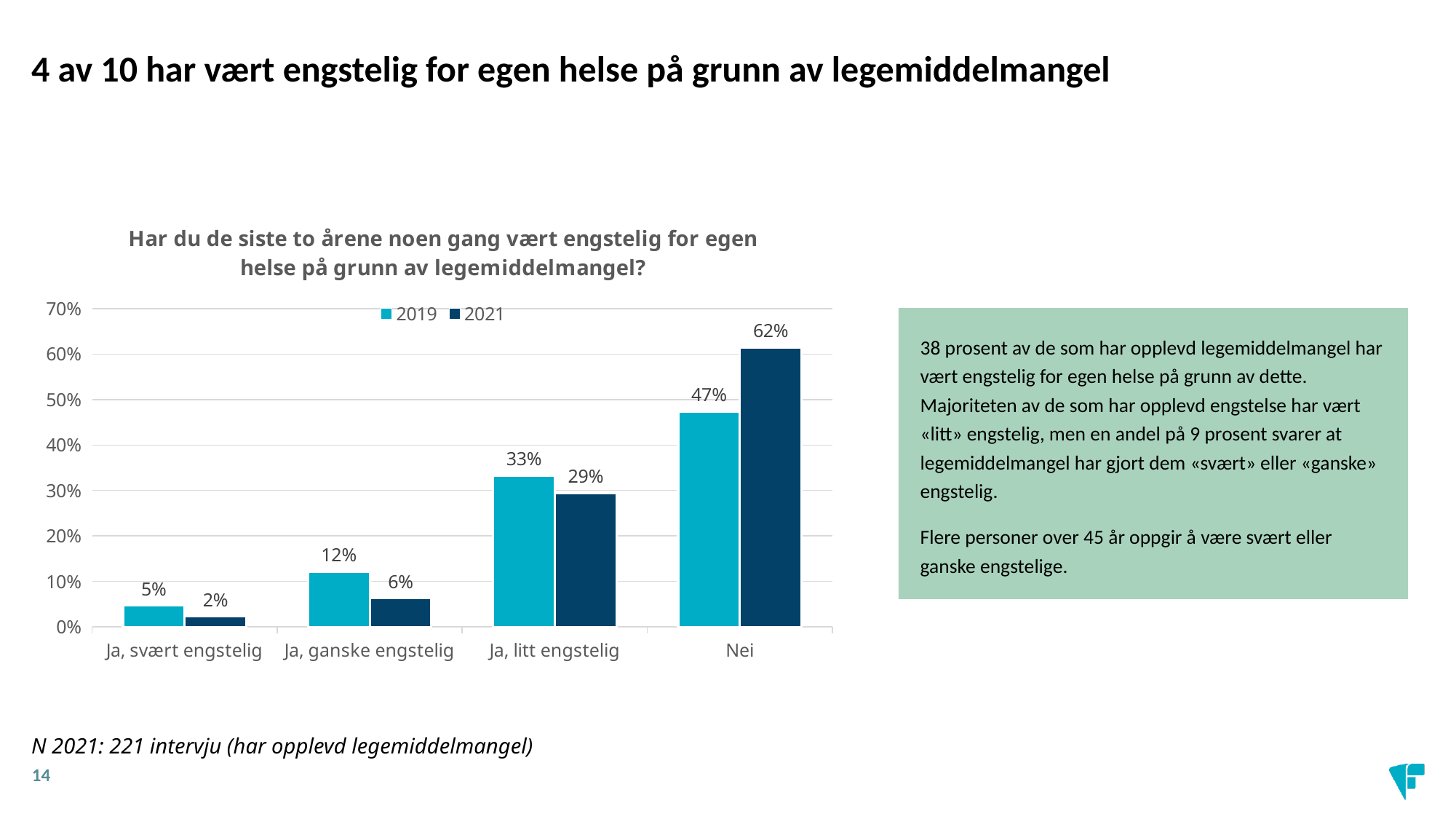
What is the difference between the 2021 and 2019 values for "Nei"? 15% What is the 2021 value for "Nei"? 62% What is the 2021 value for "Ja, ganske engstelig"? 6% Which series is shown in dark blue in the legend? 2021 Which category has the highest 2021 value? Nei Which is larger for "Ja, ganske engstelig": the 2019 value or the 2021 value? 2019 How many categories are shown on the x axis? 4 Which category has the lowest 2019 value? Ja, svært engstelig How many series does the legend list? 2 What is the 2019 value for "Ja, litt engstelig"? 33% What is the 2019 value for "Ja, svært engstelig"? 5% What kind of chart is shown on the slide? Bar chart